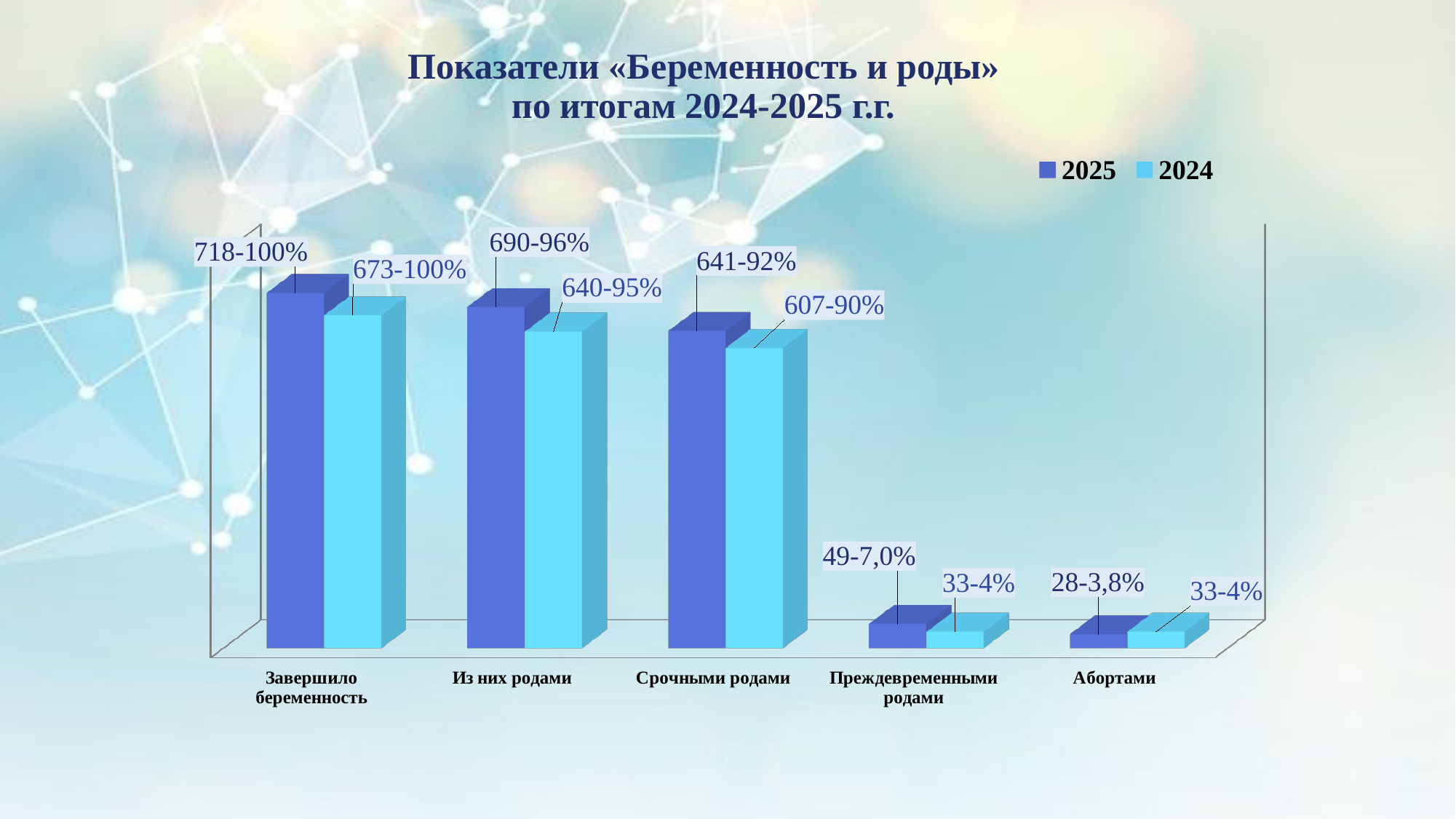
What is the data label for the 2025 series on the 'Завершило беременность' bar? 718-100% Which category has the highest value for the 2025 series? Завершило беременность What is the data label for the 2024 series on the 'Из них родами' bar? 640-95% What is the data label for the 2025 series on the 'Абортами' bar? 28-3,8% Which category has the lowest value for the 2025 series? Абортами For 'Срочными родами', which series has the larger value, 2025 or 2024? 2025 What is the data label for the 2025 series on the 'Срочными родами' bar? 641-92% By how many does the 2025 count for 'Завершило беременность' (718) exceed the 2024 count (673)? 45 How many series does the legend list? 2 How many categories are shown on the x axis? 5 What kind of chart is shown on the slide? Bar chart What is the data label for the 2024 series on the 'Преждевременными родами' bar? 33-4%